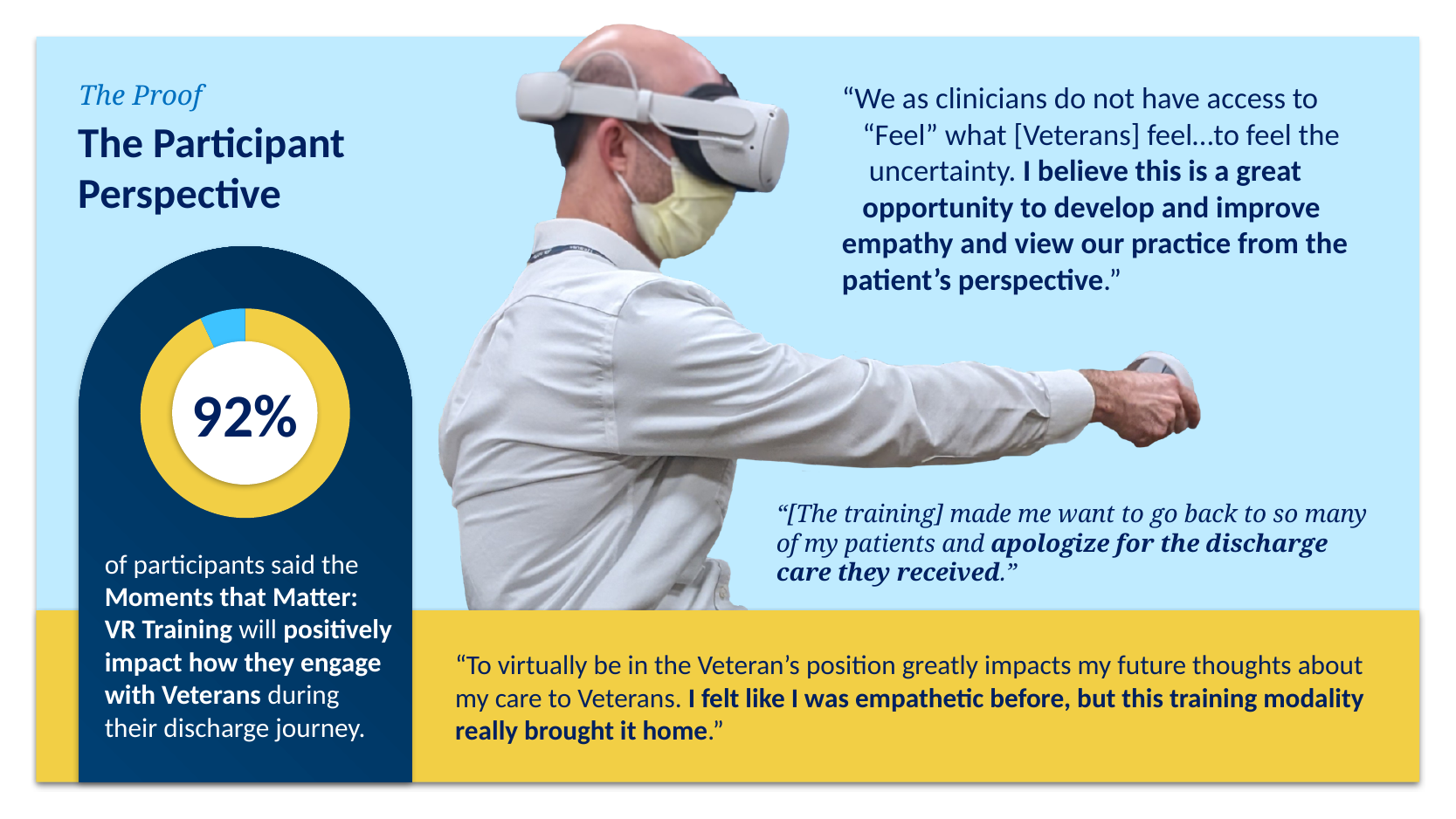
What share of participants said the Moments that Matter: VR Training will positively impact how they engage with Veterans during their discharge journey? 92% What is the heading above the donut chart on the slide? The Participant Perspective What kind of chart is shown on the left of the slide? Pie (donut) chart What percentage is printed in the centre of the donut chart? 92% What share of the donut chart is not covered by the 92% segment? 8% How many segments does the donut chart have? 2 Is the value shown in the donut chart greater or less than 50%? greater Which segment of the donut chart is larger, the yellow one or the blue one? yellow What colour is the segment representing the 92% of participants? yellow